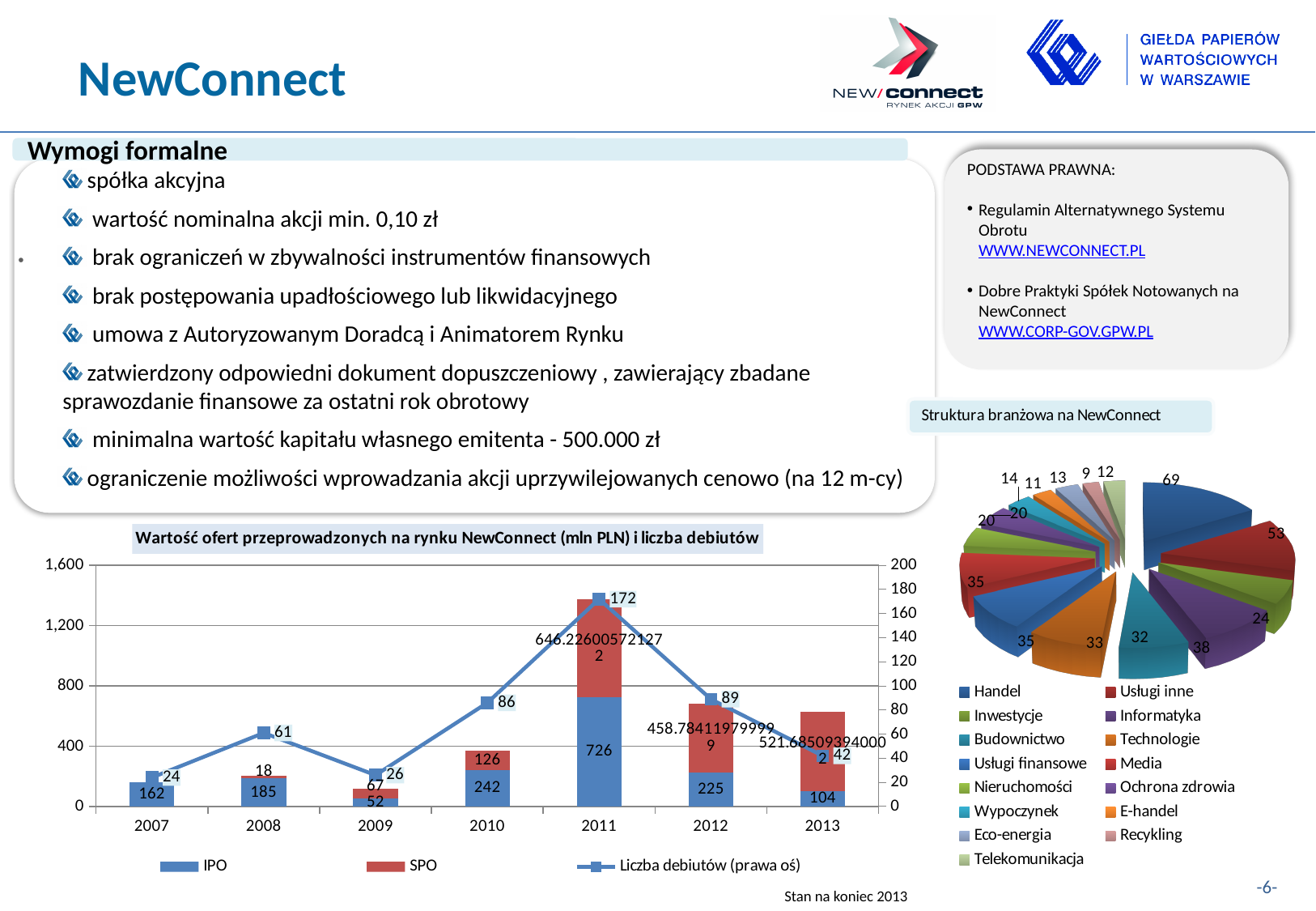
In the chart 'Wartość ofert przeprowadzonych na rynku NewConnect', which year has the larger SPO value, 2009 or 2010? 2010 In the chart 'Wartość ofert przeprowadzonych na rynku NewConnect', what is the IPO value for 2011? 726 In the chart 'Wartość ofert przeprowadzonych na rynku NewConnect', how many series does the legend list? 3 What kind of chart is the chart titled 'Struktura branżowa na NewConnect'? pie chart In the chart 'Wartość ofert przeprowadzonych na rynku NewConnect', what is the difference between the IPO values for 2011 and 2010? 484 In the chart 'Wartość ofert przeprowadzonych na rynku NewConnect', how many years are shown on the x axis? 7 In the chart 'Wartość ofert przeprowadzonych na rynku NewConnect', which year has the lowest IPO value? 2009 In the pie chart 'Struktura branżowa na NewConnect', how many sectors does the legend list? 15 In the pie chart 'Struktura branżowa na NewConnect', which sector has the largest slice? Handel In the chart 'Wartość ofert przeprowadzonych na rynku NewConnect', which year has the highest Liczba debiutów? 2011 In the chart 'Wartość ofert przeprowadzonych na rynku NewConnect', what is the value of Liczba debiutów for 2008? 61 What kind of chart is the chart titled 'Wartość ofert przeprowadzonych na rynku NewConnect (mln PLN) i liczba debiutów'? bar chart with a line